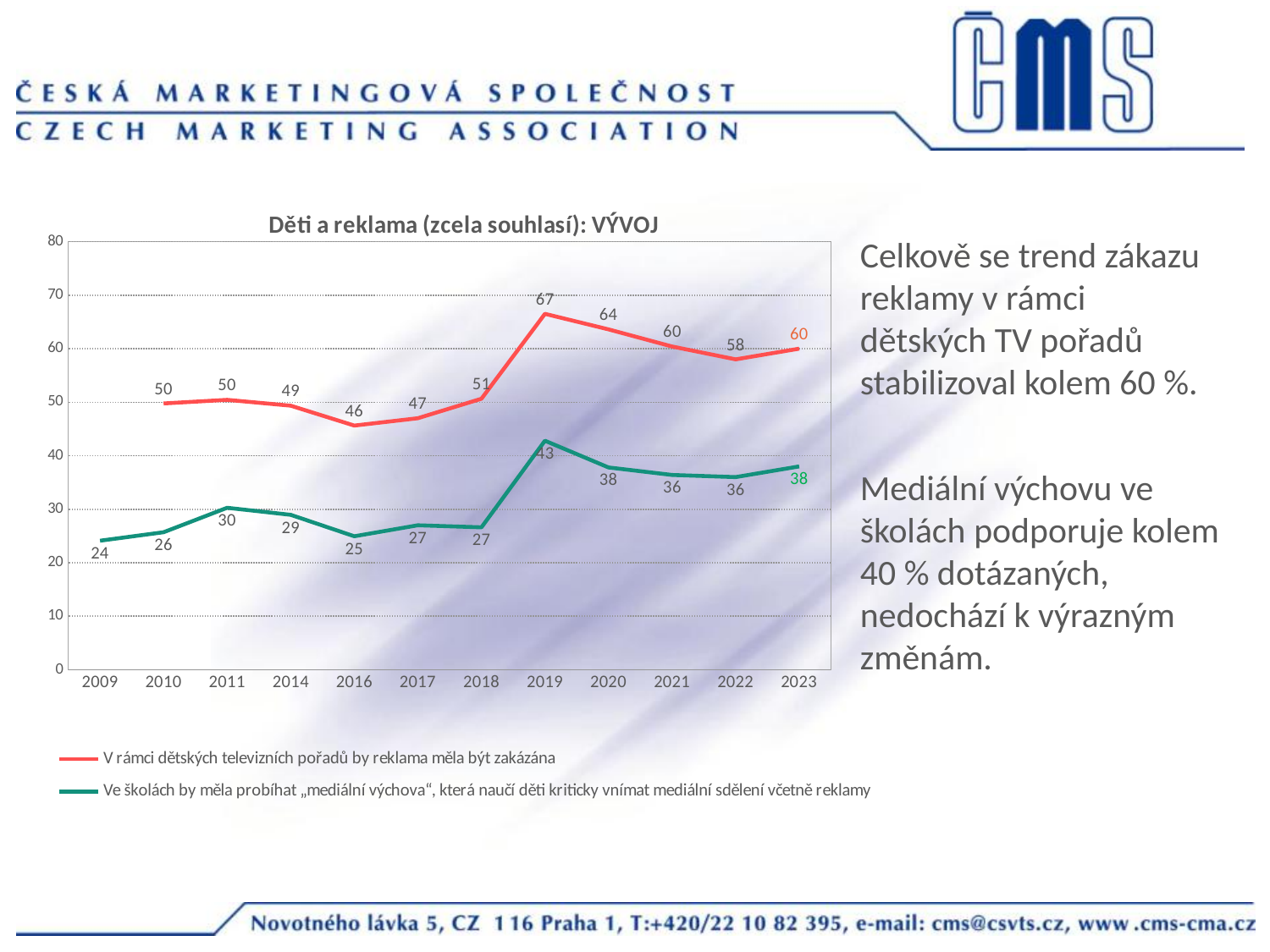
Does the red series rise or fall between 2018 and 2019? rise What is the value of the green series (Ve školách by měla probíhat „mediální výchova“) in 2009? 24 Which series has the higher value in 2016, the red one or the green one? the red one In which year does the red series reach its highest value? 2019 What is the title of the chart? Děti a reklama (zcela souhlasí): VÝVOJ How many series does the legend list? 2 Is the value of the green series in 2019 greater or less than 40? greater In which year does the green series have its lowest value? 2009 What is the value of the red series (V rámci dětských televizních pořadů by reklama měla být zakázána) in 2019? 67 What is the difference between the red series and the green series in 2023? 22 How many years are shown on the x axis? 12 What type of chart is shown on the slide? line chart